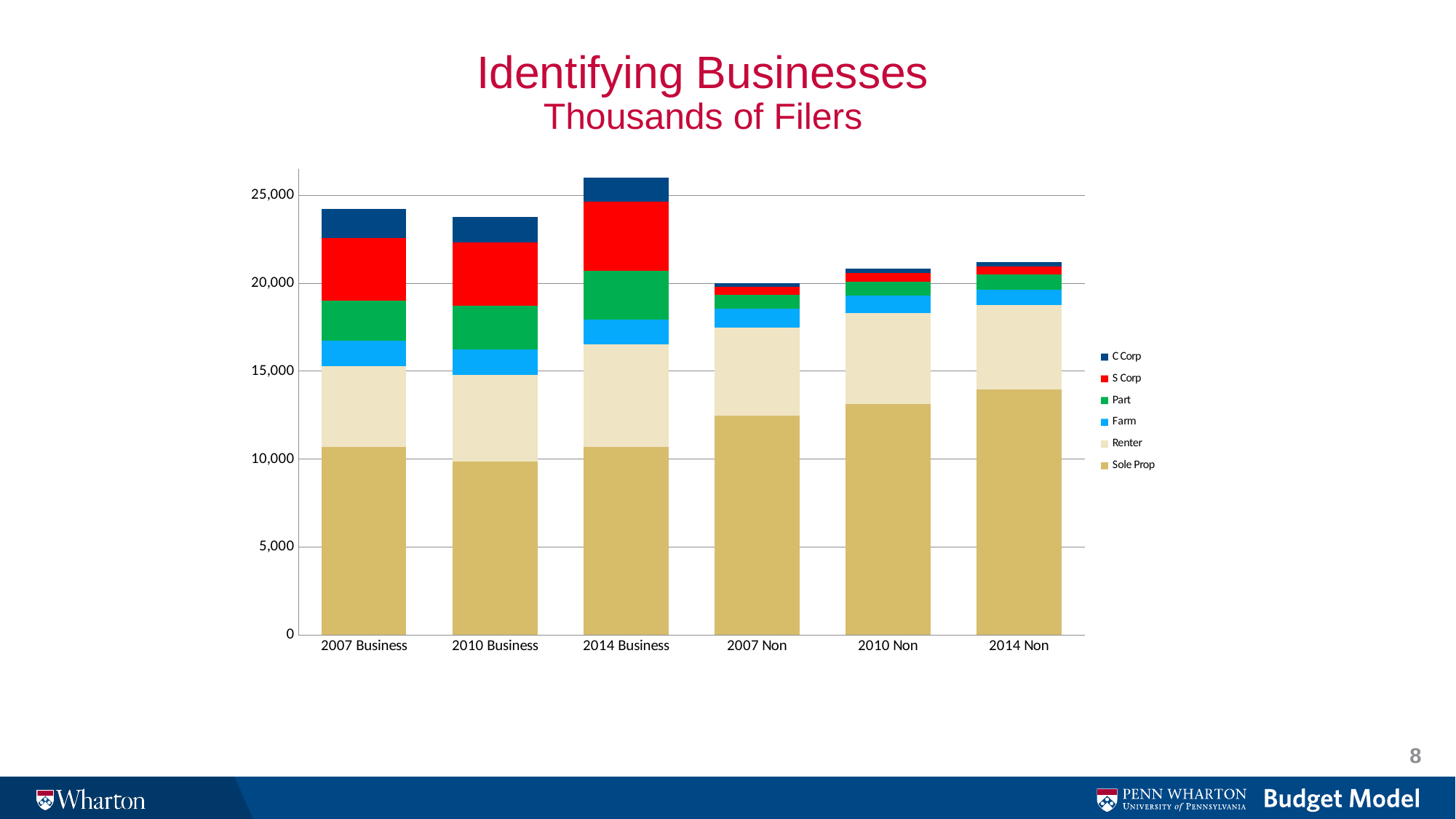
Is the total for 2007 Business greater or less than 25,000? less Is the total for 2010 Business greater or less than 20,000? greater Is the Sole Prop value for 2014 Non greater or less than 10,000? greater Which series is shown at the bottom of each stacked bar? Sole Prop Which category has the tallest stacked bar? 2014 Business How many series does the chart's legend list? 6 How many categories are shown along the x axis of the chart? 6 What kind of chart is shown on the slide? Stacked bar chart Across the Non categories from 2007 to 2014, does the Sole Prop value rise or fall? Rise Which is larger, the total for 2014 Business or the total for 2007 Non? 2014 Business Which is larger, the Sole Prop value for 2014 Non or the Sole Prop value for 2007 Business? 2014 Non